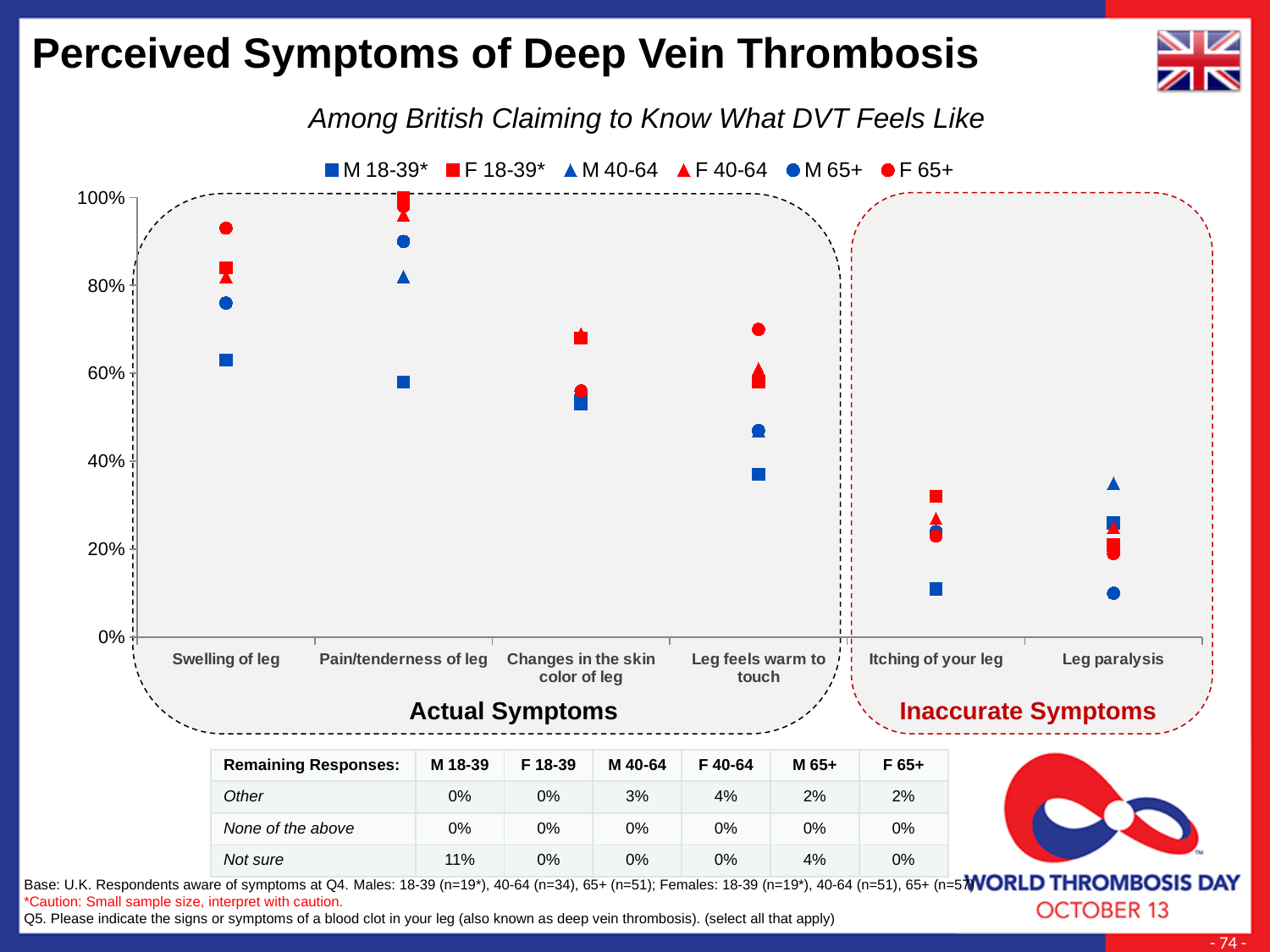
For which symptom is the F 18-39* value the highest? Pain/tenderness of leg How many series does the chart legend list? 6 For which symptom is the M 18-39* value the lowest? Itching of your leg Is the value for M 18-39* for Pain/tenderness of leg greater or less than 80%? less Is the value for M 18-39* for Swelling of leg greater or less than 60%? greater Is the value for F 65+ for Leg feels warm to touch greater or less than 60%? greater How many symptom categories are plotted along the x axis? 6 What kind of chart is shown on the slide? Scatter (dot) plot Which symptoms are grouped under the 'Inaccurate Symptoms' label? Itching of your leg and Leg paralysis Which is larger for M 18-39*: the value for Swelling of leg or the value for Leg feels warm to touch? Swelling of leg